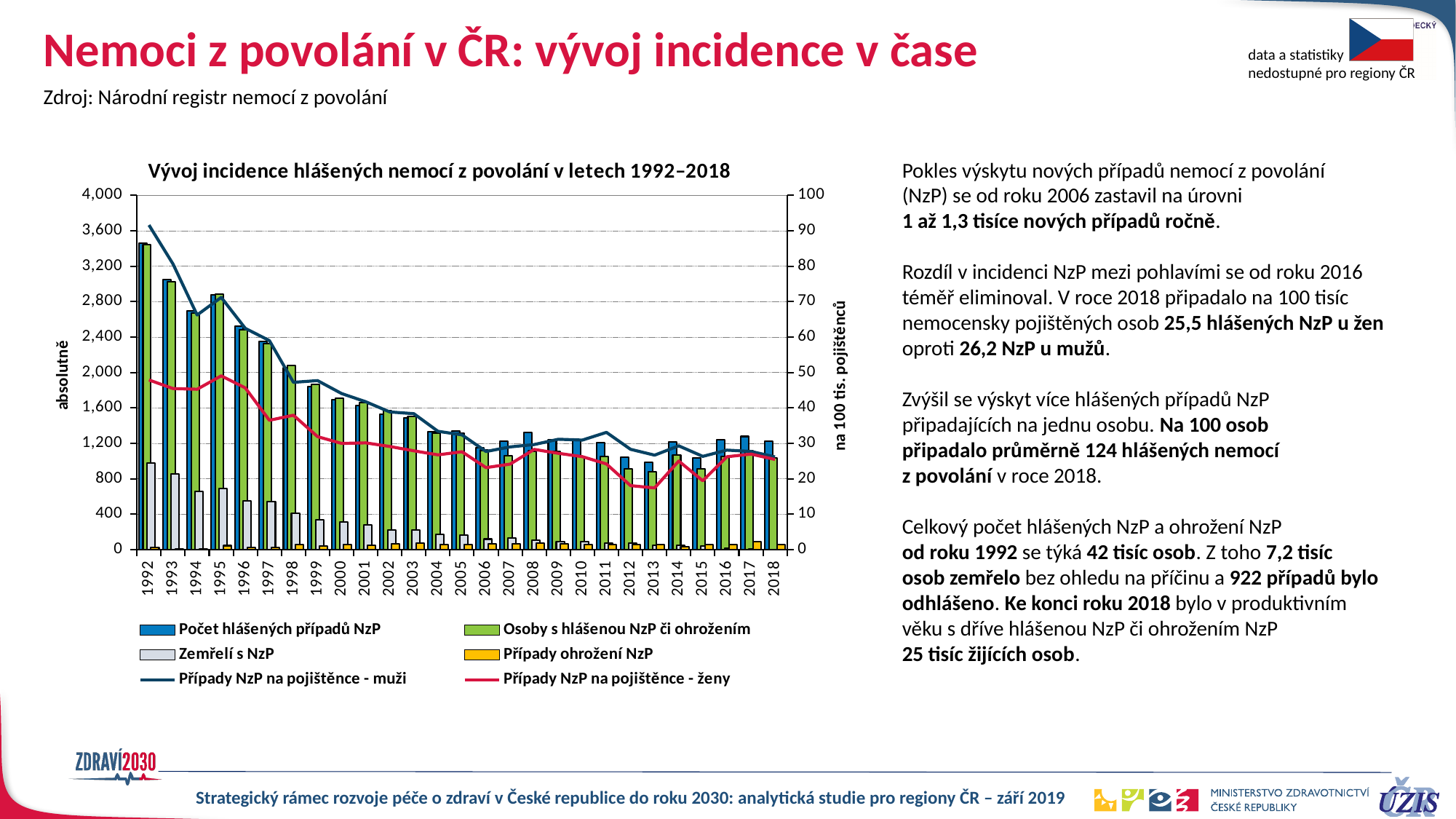
Which is larger, the value for Počet hlášených případů NzP in 1992 or in 2018? 1992 How many years are shown on the x axis of the chart? 27 Is the value for Případy NzP na pojištěnce - muži in 1992 greater or less than 80? greater Does the value for Počet hlášených případů NzP rise or fall from 1992 to 2006? fall Is the value for Počet hlášených případů NzP in 2018 greater or less than 1,600? less How many series does the chart legend list? 6 Is the value for Případy NzP na pojištěnce - ženy in 2013 greater or less than 20? less What is the title of the chart? Vývoj incidence hlášených nemocí z povolání v letech 1992–2018 What kind of chart is shown on the slide? Combined bar and line chart In which year is the value for Počet hlášených případů NzP highest? 1992